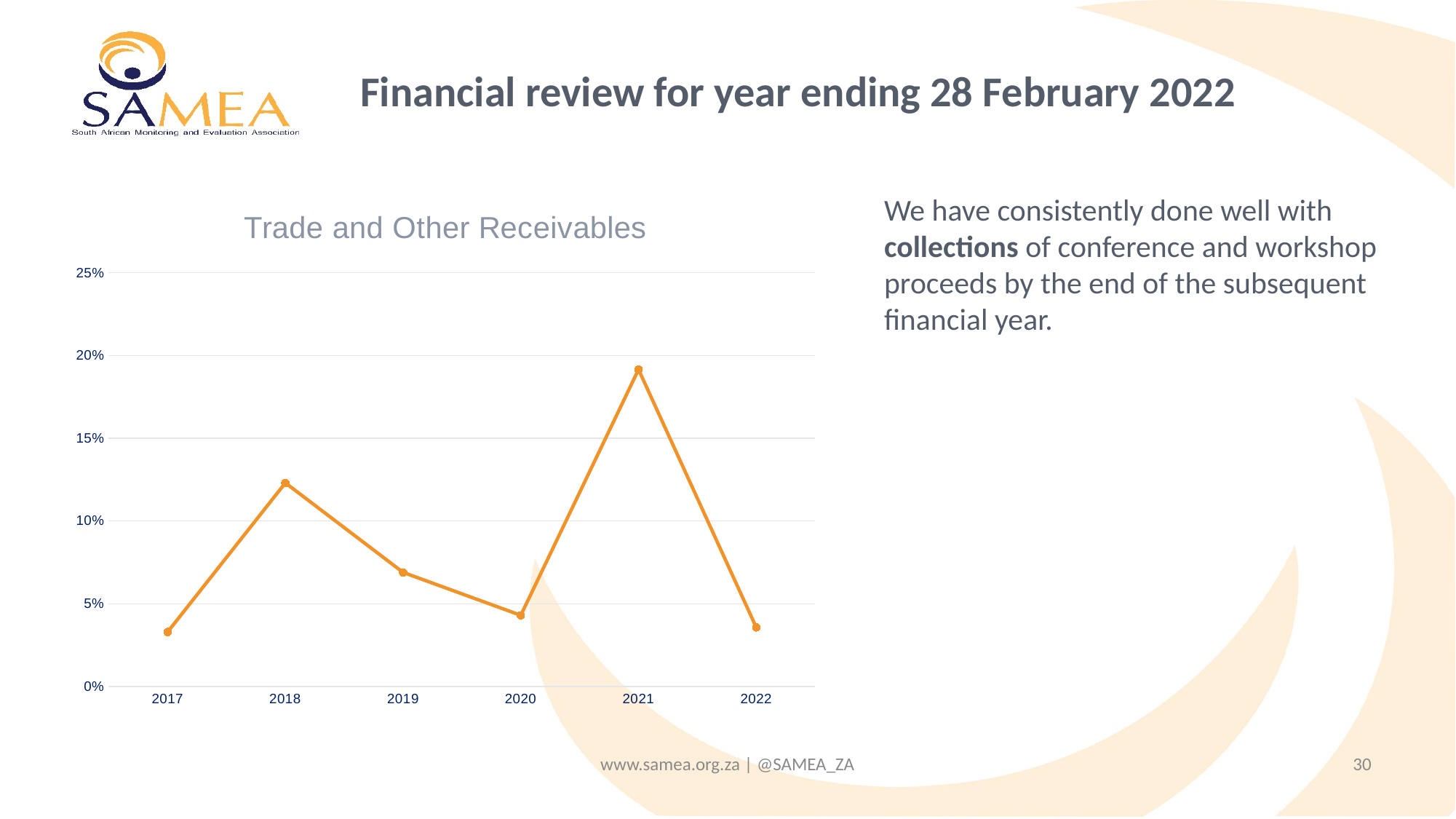
Is the value for 2017 greater or less than 5%? less Which year has the larger value, 2018 or 2019? 2018 Do the values rise or fall from 2018 to 2020? fall Is the value for 2021 greater or less than 15%? greater Is the value for 2020 greater or less than 5%? less What is the title of the chart? Trade and Other Receivables Which year has the highest value for Trade and Other Receivables? 2021 What kind of chart is shown on the slide? line chart What is the highest value shown on the y axis of the chart? 25% How many years are plotted on the x axis of the chart? 6